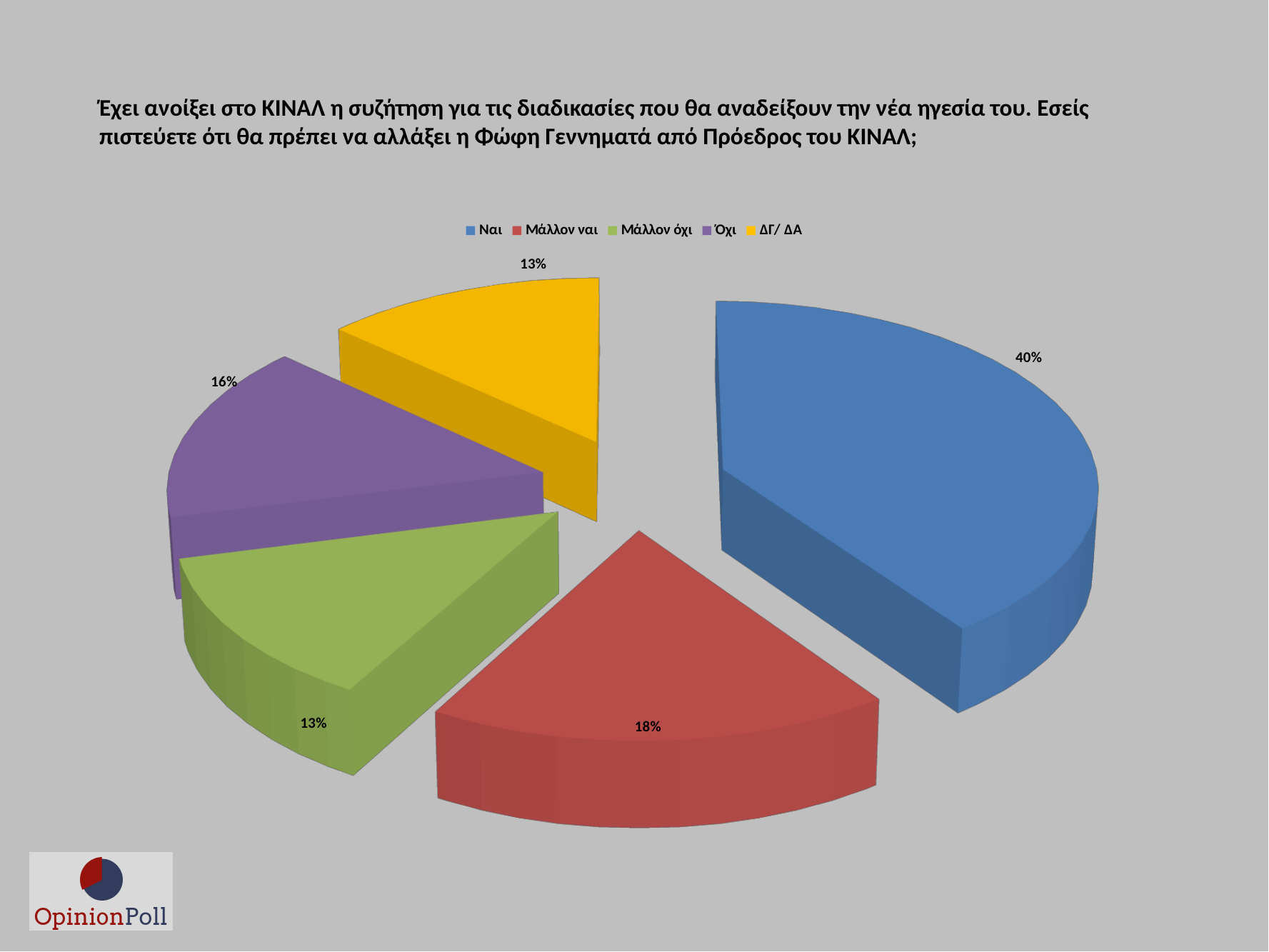
What is the difference in percentage points between "Ναι" and "Μάλλον ναι"? 22 What colour is the slice for "ΔΓ/ ΔΑ"? yellow What percentage of respondents answered "Ναι"? 40% Which response has the largest share of the pie? Ναι How many slices does the pie chart have? 5 What percentage of respondents answered "Μάλλον ναι"? 18% What percentage of respondents answered "Όχι"? 16% What percentage of respondents answered "Μάλλον όχι"? 13% How many entries does the legend list? 5 Which is larger, the share for "Όχι" or the share for "Μάλλον όχι"? Όχι What kind of chart is shown on the slide? pie chart What percentage of respondents answered "ΔΓ/ ΔΑ"? 13%